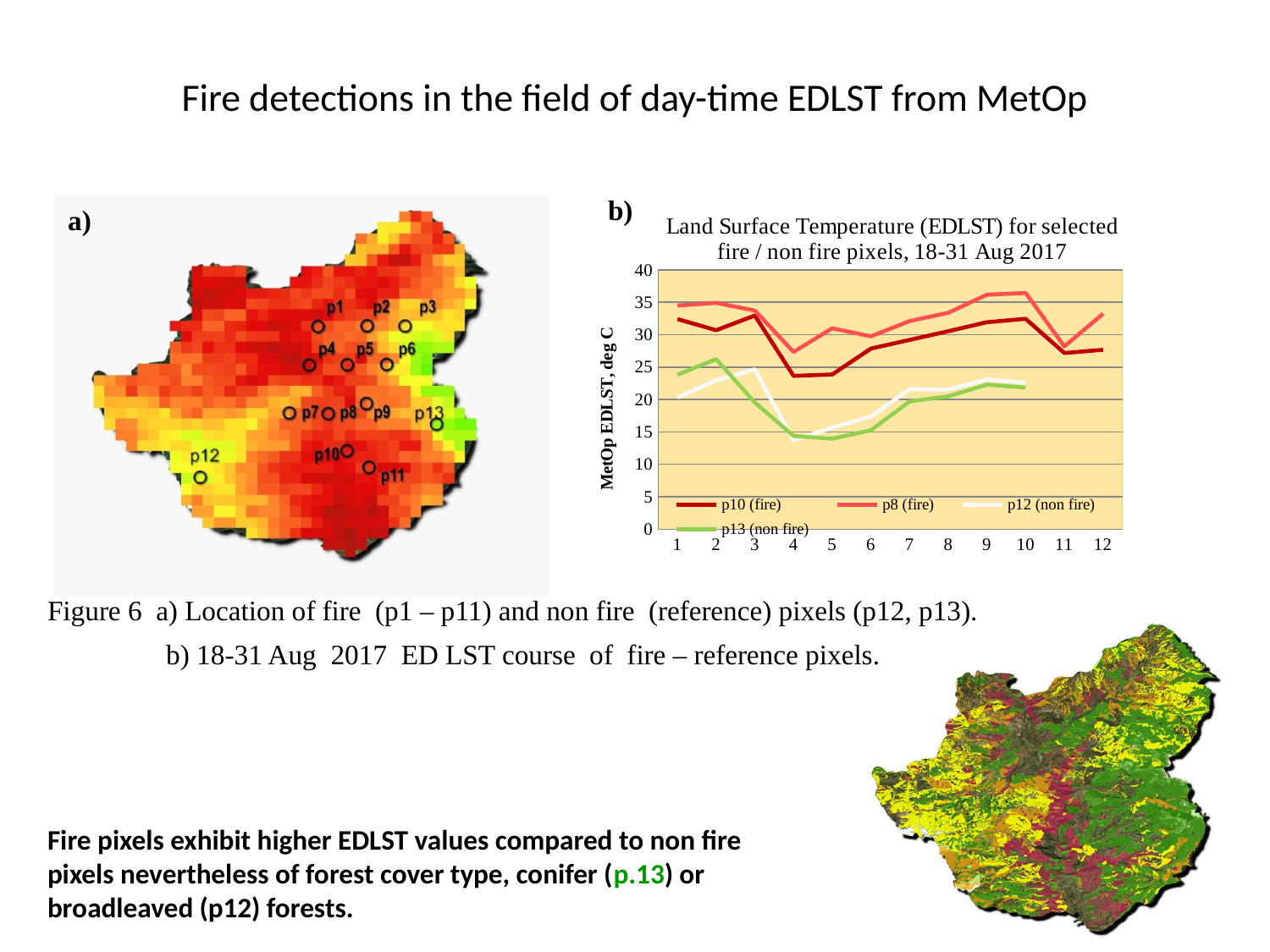
In the Land Surface Temperature chart, which series reaches the highest value overall? p8 (fire) What kind of chart is shown in panel b)? line chart In the Land Surface Temperature chart, is the value for p8 (fire) at point 10 greater or less than 35? greater In the Land Surface Temperature chart, is the value for p10 (fire) at point 4 greater or less than 25? less In the Land Surface Temperature chart, is the value for p12 (non fire) at point 3 greater or less than 20? greater How many points are marked along the x axis of the Land Surface Temperature chart? 12 In the Land Surface Temperature chart, at point 1, which is higher: p8 (fire) or p10 (fire)? p8 (fire) How many series does the legend of the Land Surface Temperature chart list? 4 What is the y-axis title of the Land Surface Temperature chart? MetOp EDLST, deg C In the Land Surface Temperature chart, at point 2, which is higher: p12 (non fire) or p13 (non fire)? p13 (non fire) In the Land Surface Temperature chart, does the p10 (fire) line rise or fall from point 4 to point 10? rise